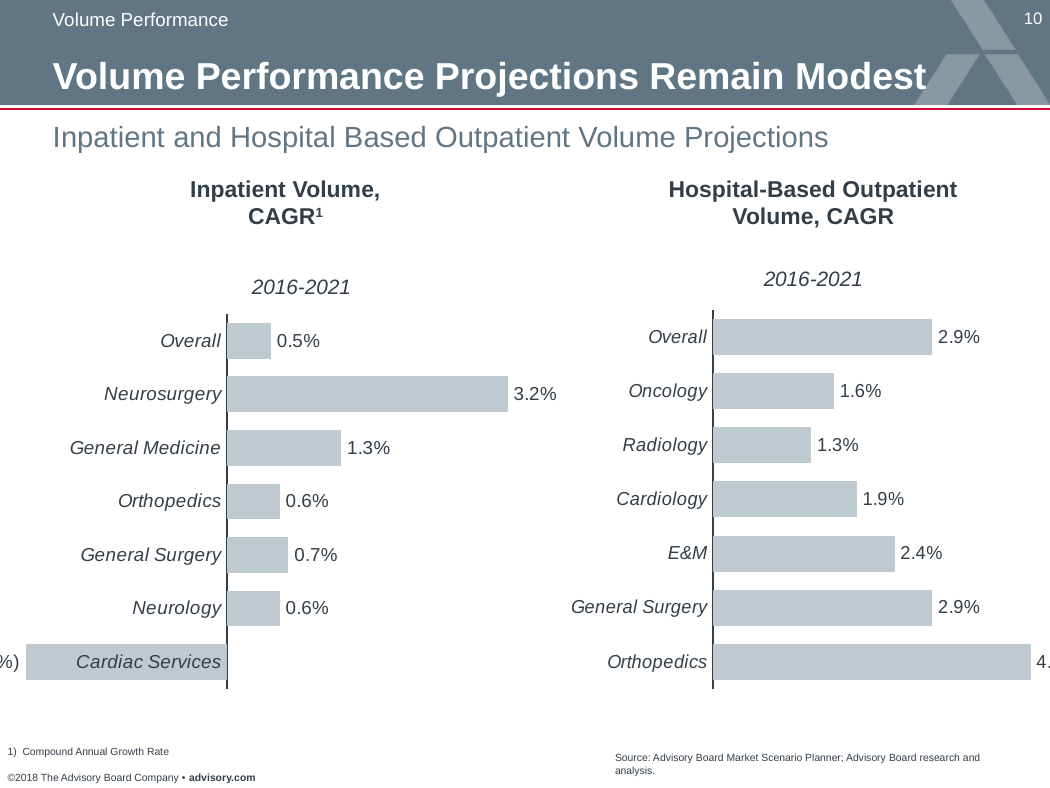
What time period do both charts cover? 2016-2021 In the Hospital-Based Outpatient Volume, CAGR chart, what is the value for Cardiology? 1.9% In the Hospital-Based Outpatient Volume, CAGR chart, which is larger, Oncology or E&M? E&M In the Inpatient Volume, CAGR chart, what is the value for General Medicine? 1.3% In the Inpatient Volume, CAGR chart, what is the difference between Neurosurgery and General Medicine? 1.9% In the Hospital-Based Outpatient Volume, CAGR chart, what is the value for E&M? 2.4% In the Inpatient Volume, CAGR chart, what is the value for Neurosurgery? 3.2% How many categories are shown in the Inpatient Volume, CAGR chart? 7 In the Hospital-Based Outpatient Volume, CAGR chart, which category has the highest value? Orthopedics In the Inpatient Volume, CAGR chart, which category has the highest value? Neurosurgery What kind of chart is the Hospital-Based Outpatient Volume, CAGR chart? Bar chart In the Hospital-Based Outpatient Volume, CAGR chart, which category has the lowest value? Radiology